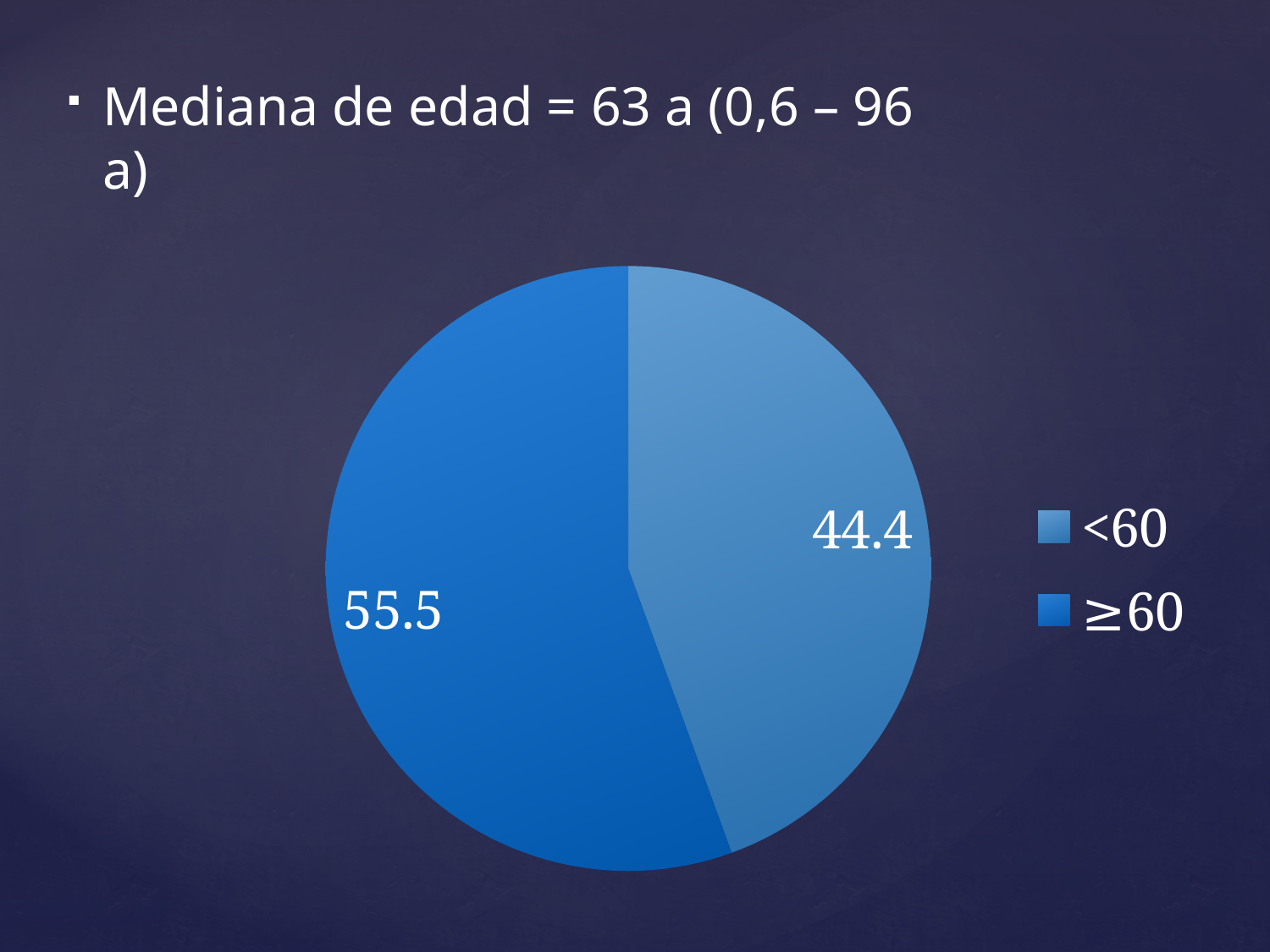
Which legend entry is shown in the lighter blue colour? <60 What is the value for the <60 slice? 44.4 What kind of chart is shown on the slide? pie chart How many entries does the legend list? 2 Which slice is the largest? ≥60 How many slices does the pie chart have? 2 What median age is stated in the text above the chart? 63 a What is the difference between the ≥60 value and the <60 value? 11.1 Which is larger, the <60 slice or the ≥60 slice? ≥60 Which slice is the smallest? <60 What is the value for the ≥60 slice? 55.5